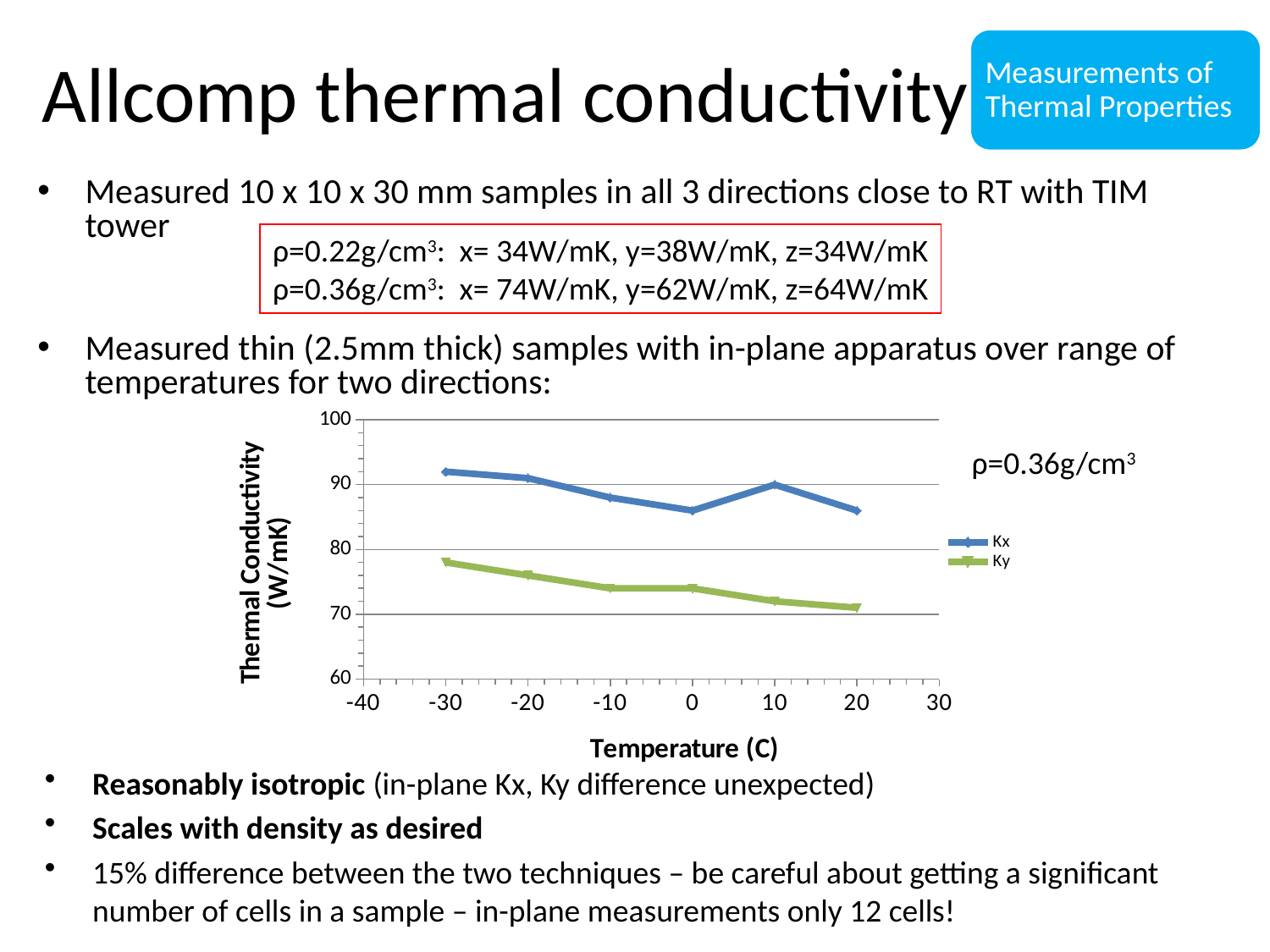
What are the two series named in the chart's legend? Kx and Ky Is the Kx value at 0 C greater or less than 90? less Which series is plotted in green? Ky At 0 C, which series has the larger thermal conductivity, Kx or Ky? Kx How many series does the chart's legend list? 2 Does the Ky series rise or fall as temperature increases from -30 C to 20 C? fall Is the Ky value at -30 C greater or less than 80? less What kind of chart is shown on the slide? line chart How many data points are plotted for the Kx series? 6 Is the Kx value at -30 C greater or less than 90? greater What is the title of the chart's x axis? Temperature (C)